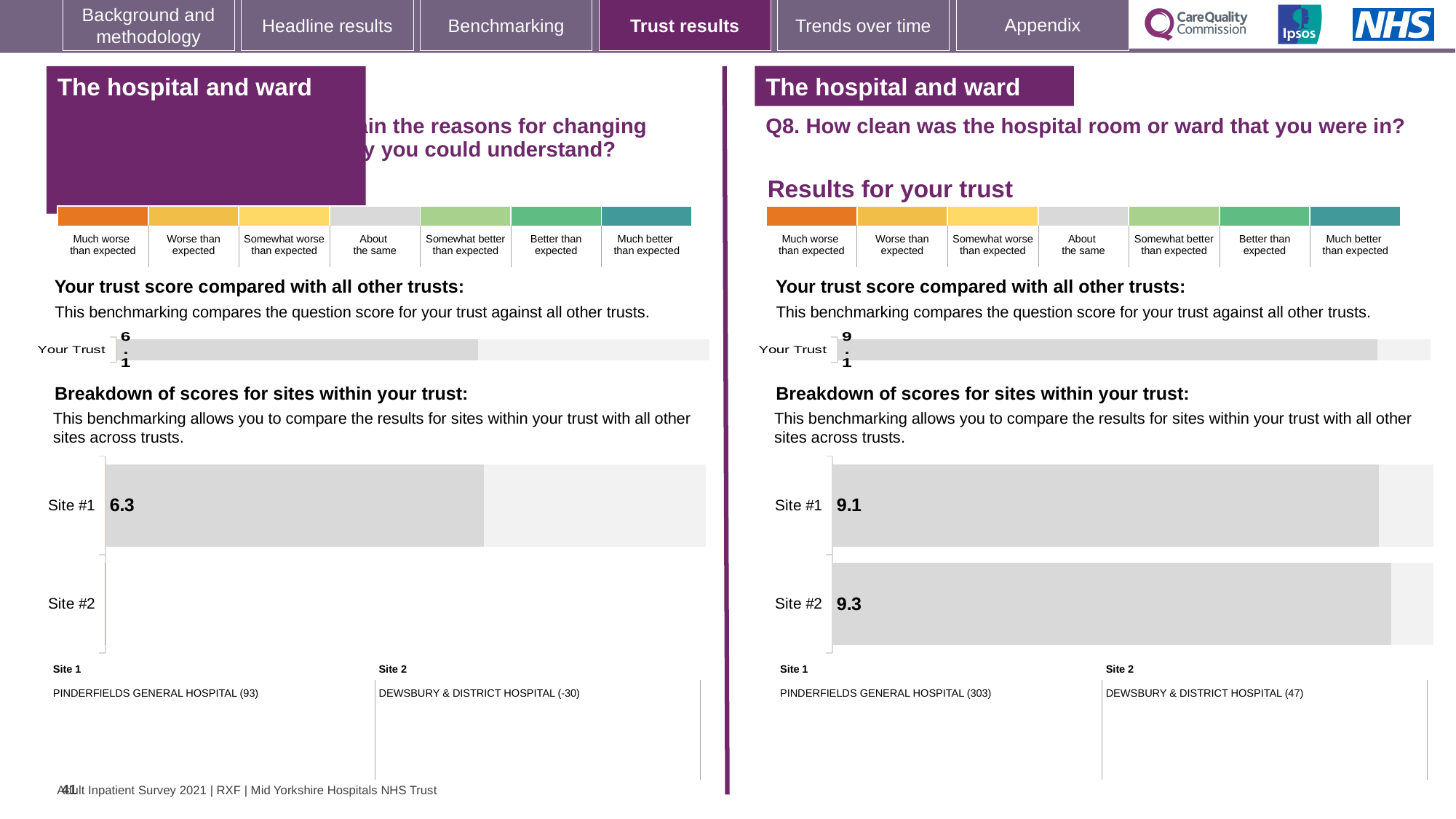
In the left-hand chart, what is the score shown for Your Trust? 6.1 In the left-hand breakdown of scores for sites, how many sites have a score bar plotted? 1 In the right-hand Q8 breakdown of scores for sites, what is the score for Site #1? 9.1 In the right-hand Q8 breakdown of scores for sites, what is the score for Site #2? 9.3 In the right-hand Q8 breakdown of scores for sites, what is the difference between the Site #2 and Site #1 scores? 0.2 What type of chart is used to show the breakdown of scores for sites within the trust? Bar chart In the right-hand Q8 breakdown of scores for sites, which site has the higher score? Site #2 How many sites are listed in the right-hand Q8 breakdown of scores for sites? 2 Which is larger: the Your Trust score in the left-hand chart or the Your Trust score in the right-hand Q8 chart? The right-hand Q8 chart In the right-hand Q8 chart, which hospital is listed as Site 1? PINDERFIELDS GENERAL HOSPITAL (303) In the left-hand breakdown of scores for sites, what is the score for Site #1? 6.3 In the right-hand chart for Q8 (How clean was the hospital room or ward), what is the score shown for Your Trust? 9.1